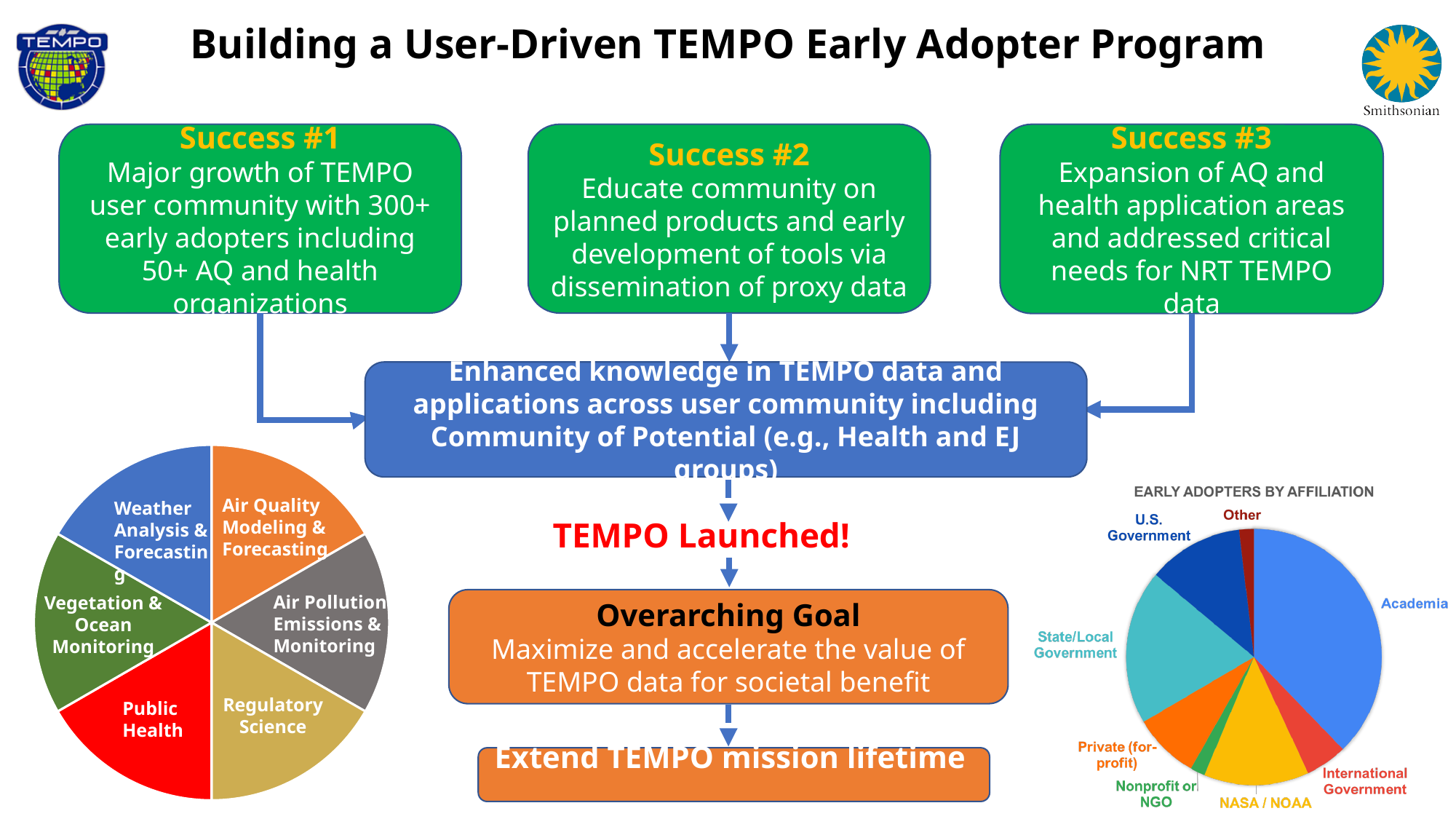
In the EARLY ADOPTERS BY AFFILIATION pie chart, which slice is larger: U.S. Government or International Government? U.S. Government In the pie chart at the bottom left of the slide, what colour is the Public Health slice? red In the EARLY ADOPTERS BY AFFILIATION pie chart, which slice is larger: Private (for-profit) or Nonprofit or NGO? Private (for-profit) In the EARLY ADOPTERS BY AFFILIATION pie chart, which slice is larger: State/Local Government or NASA / NOAA? State/Local Government What kind of chart is shown at the bottom left of the slide with slices such as Public Health and Regulatory Science? pie chart In the EARLY ADOPTERS BY AFFILIATION pie chart, which affiliation has the largest slice? Academia What is the title of the pie chart on the right side of the slide? EARLY ADOPTERS BY AFFILIATION What kind of chart is the EARLY ADOPTERS BY AFFILIATION chart on the right of the slide? pie chart How many affiliation categories are shown in the EARLY ADOPTERS BY AFFILIATION pie chart? 8 How many slices does the pie chart at the bottom left of the slide have? 6